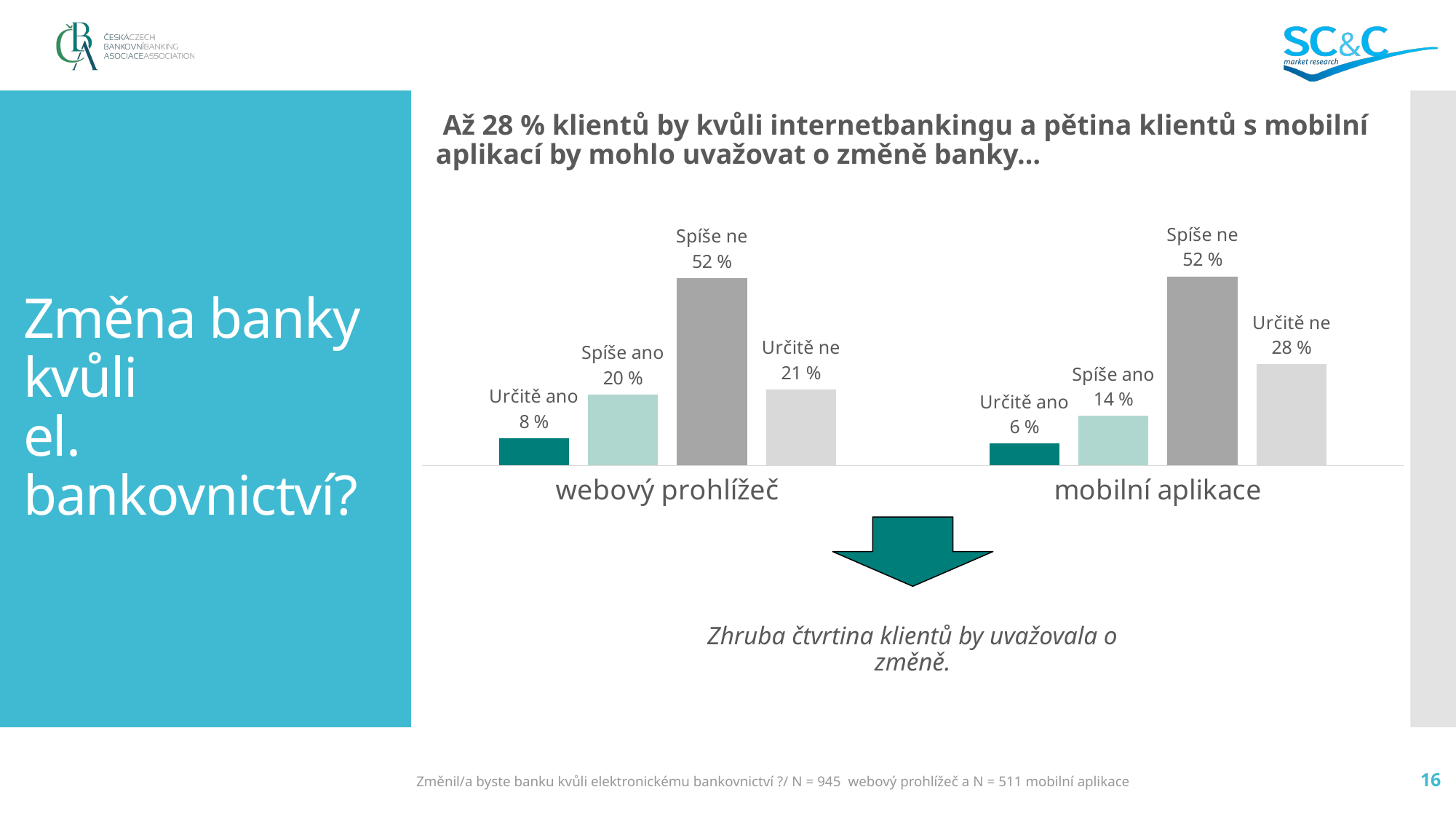
What is the value for "Spíše ano" in the "webový prohlížeč" group? 20 % What is the difference between "Spíše ano" for "webový prohlížeč" and "Spíše ano" for "mobilní aplikace"? 6 % Which is larger: "Určitě ano" for "webový prohlížeč" or "Určitě ano" for "mobilní aplikace"? webový prohlížeč What kind of chart is shown on the slide? bar chart What is the value for "Určitě ano" in the "mobilní aplikace" group? 6 % What are the two group labels shown below the bars? webový prohlížeč and mobilní aplikace Which response has the highest value in the "mobilní aplikace" group? Spíše ne What is the difference between "Určitě ne" for "mobilní aplikace" and "Určitě ne" for "webový prohlížeč"? 7 % Which response has the lowest value in the "webový prohlížeč" group? Určitě ano What is the value for "Určitě ne" in the "mobilní aplikace" group? 28 % How many bars are shown in the "webový prohlížeč" group? 4 What is the value for "Spíše ne" in the "webový prohlížeč" group? 52 %